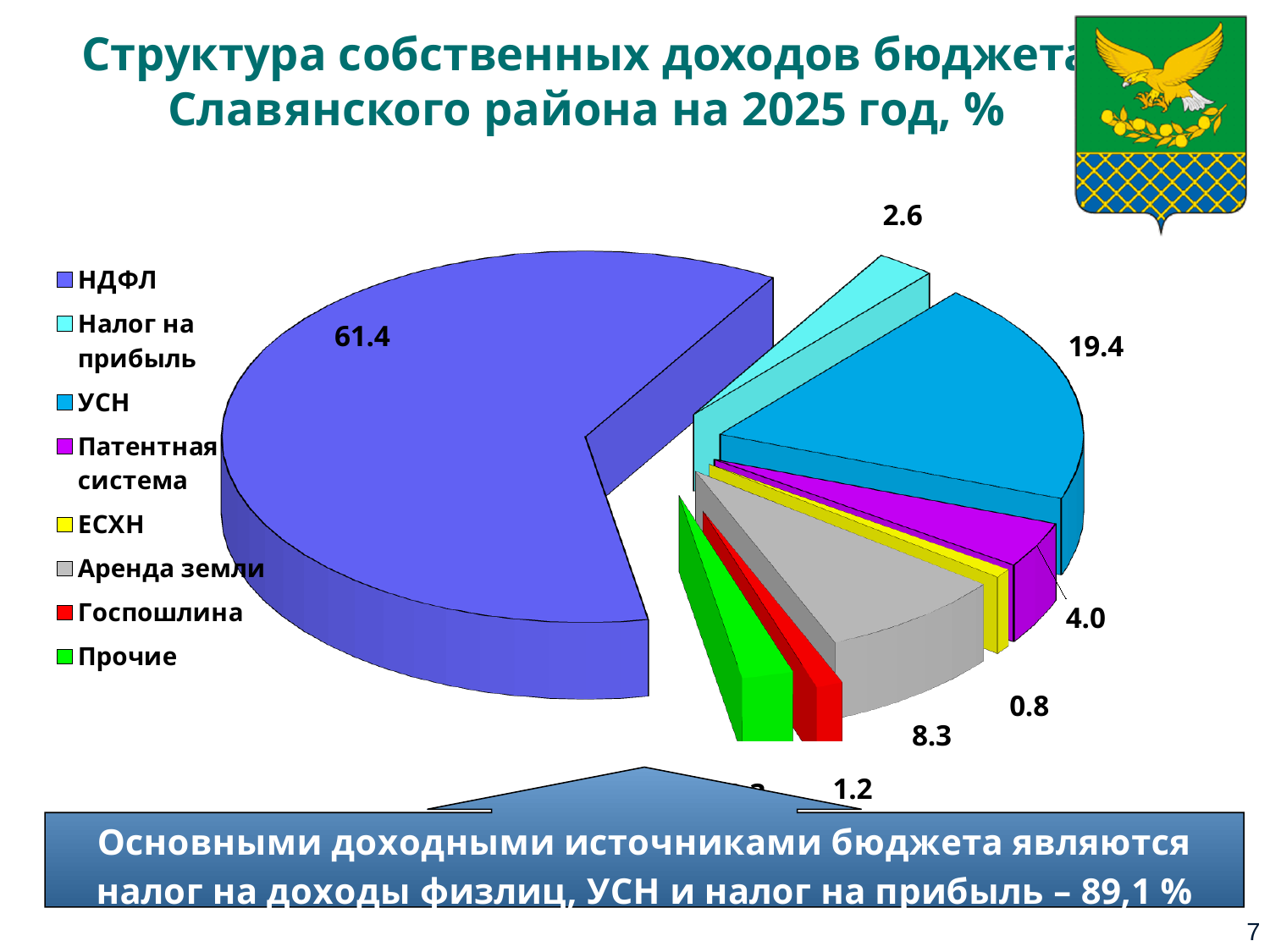
Which category has the largest share of the pie? НДФЛ Which is larger, Аренда земли or Патентная система? Аренда земли What is the value for Патентная система? 4.0 How many categories does the legend list? 8 What is the value for ЕСХН? 0.8 Which category has the smallest share of the pie? ЕСХН What is the value for НДФЛ? 61.4 What is the value for УСН? 19.4 What is the difference between the values for НДФЛ and УСН? 42.0 What is the value for Аренда земли? 8.3 What is the value for Налог на прибыль? 2.6 What type of chart is shown on the slide? pie chart